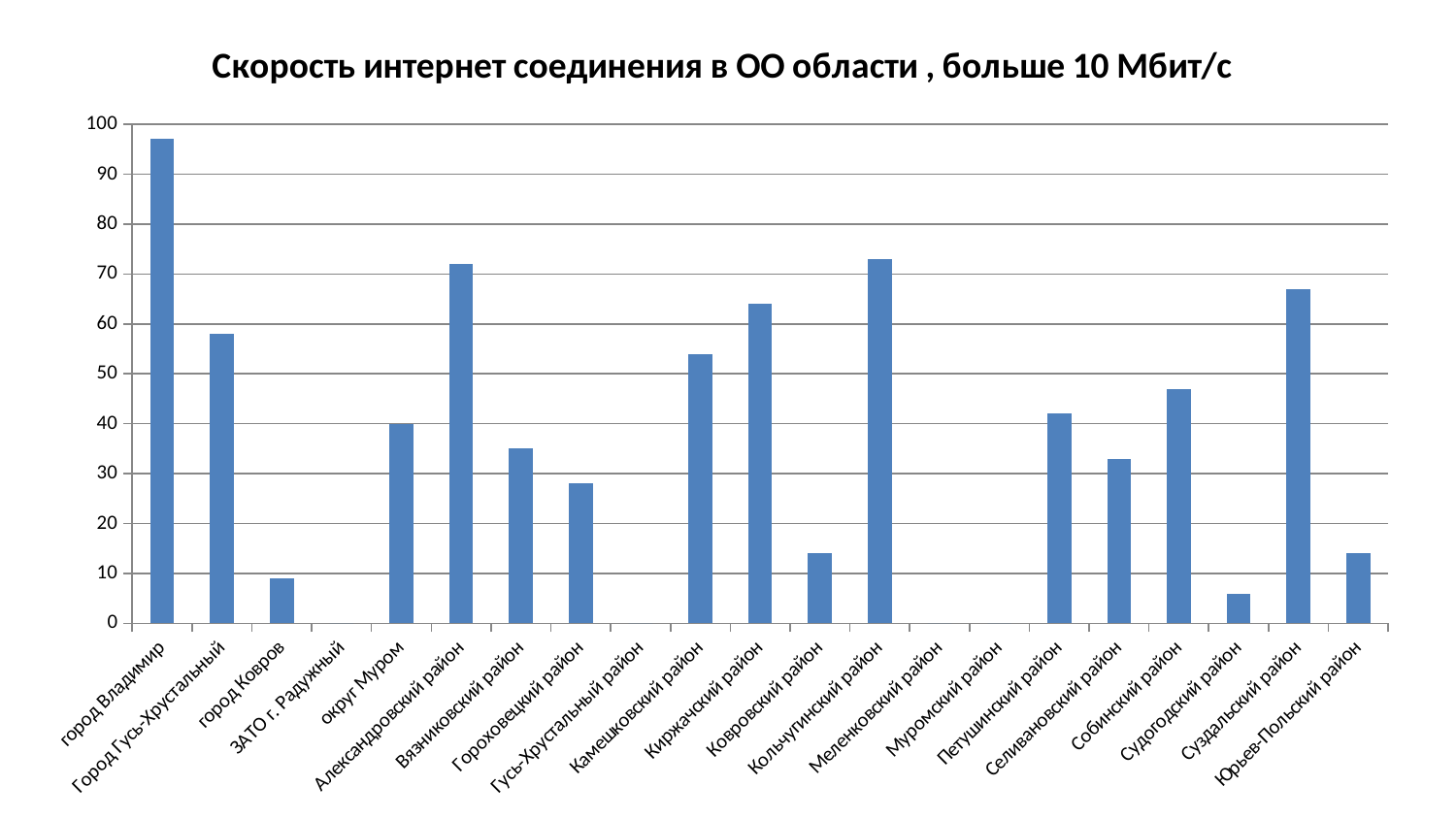
Is the value for город Владимир greater or less than 90? greater What is the title of the chart? Скорость интернет соединения в ОО области , больше 10 Мбит/с Is the value for Вязниковский район greater or less than 40? less What kind of chart is shown on the slide? bar chart Which is larger, the value for город Владимир or the value for Кольчугинский район? город Владимир Is the value for Судогодский район greater or less than 10? less Which is larger, the value for Александровский район or the value for округ Муром? Александровский район Which category has the highest value? город Владимир How many categories are listed along the x axis? 21